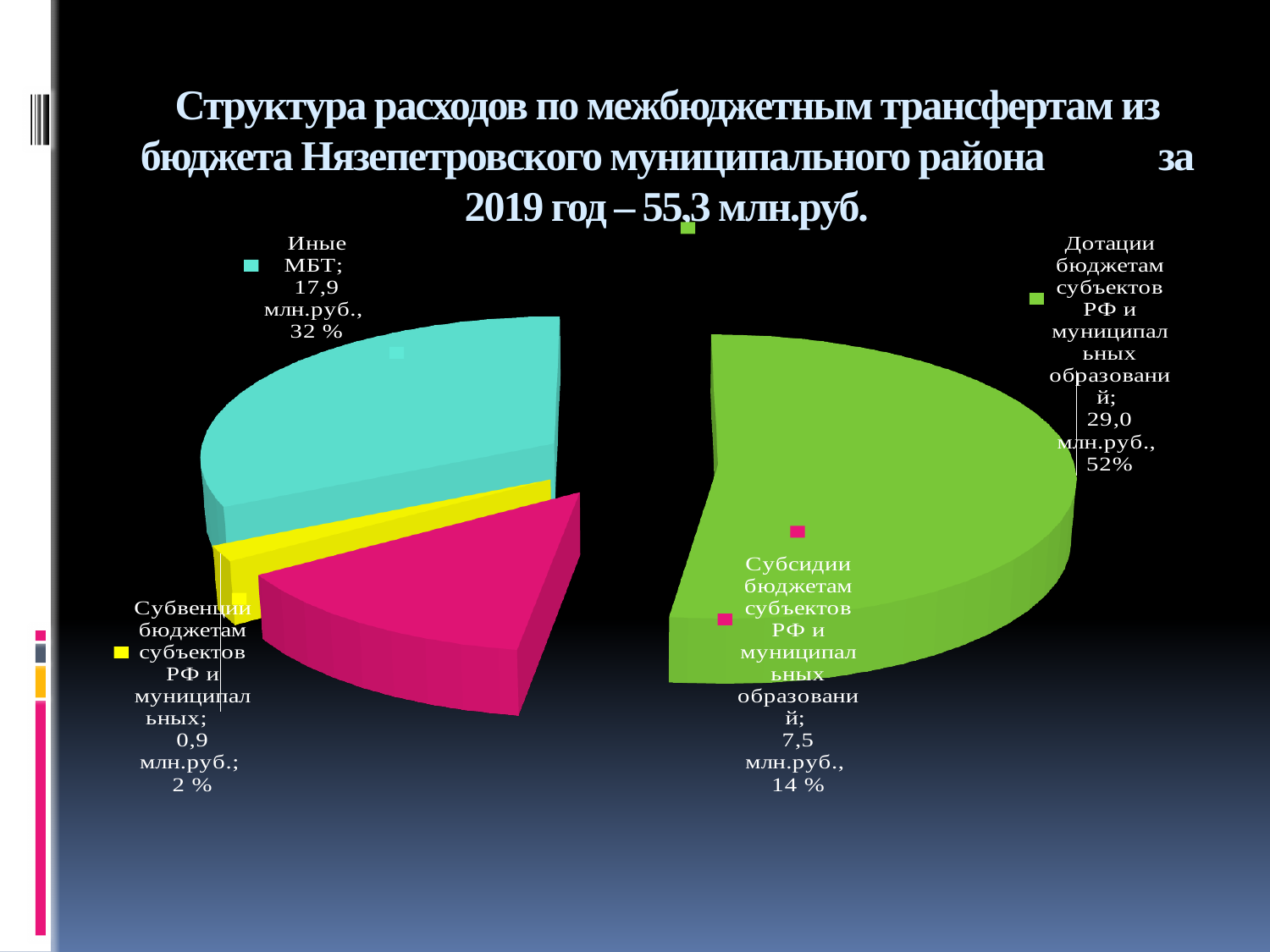
What is the value for Субсидии бюджетам субъектов РФ и муниципальных образований? 7,5 млн.руб. How many slices does the pie chart have? 4 What is the value for Иные МБТ? 17,9 млн.руб. What is the value for Дотации бюджетам субъектов РФ и муниципальных образований? 29,0 млн.руб. What share of the pie does Иные МБТ represent? 32 % Which category has the largest slice of the pie? Дотации бюджетам субъектов РФ и муниципальных образований What kind of chart is shown on the slide? pie chart What is the value for Субвенции бюджетам субъектов РФ и муниципальных образований? 0,9 млн.руб. What share of the pie does Субсидии бюджетам субъектов РФ и муниципальных образований represent? 14 % Which category has the smallest slice of the pie? Субвенции бюджетам субъектов РФ и муниципальных образований Which is larger, the value for Субсидии or the value for Субвенции? Субсидии What is the difference between the values for Дотации and Иные МБТ? 11,1 млн.руб.